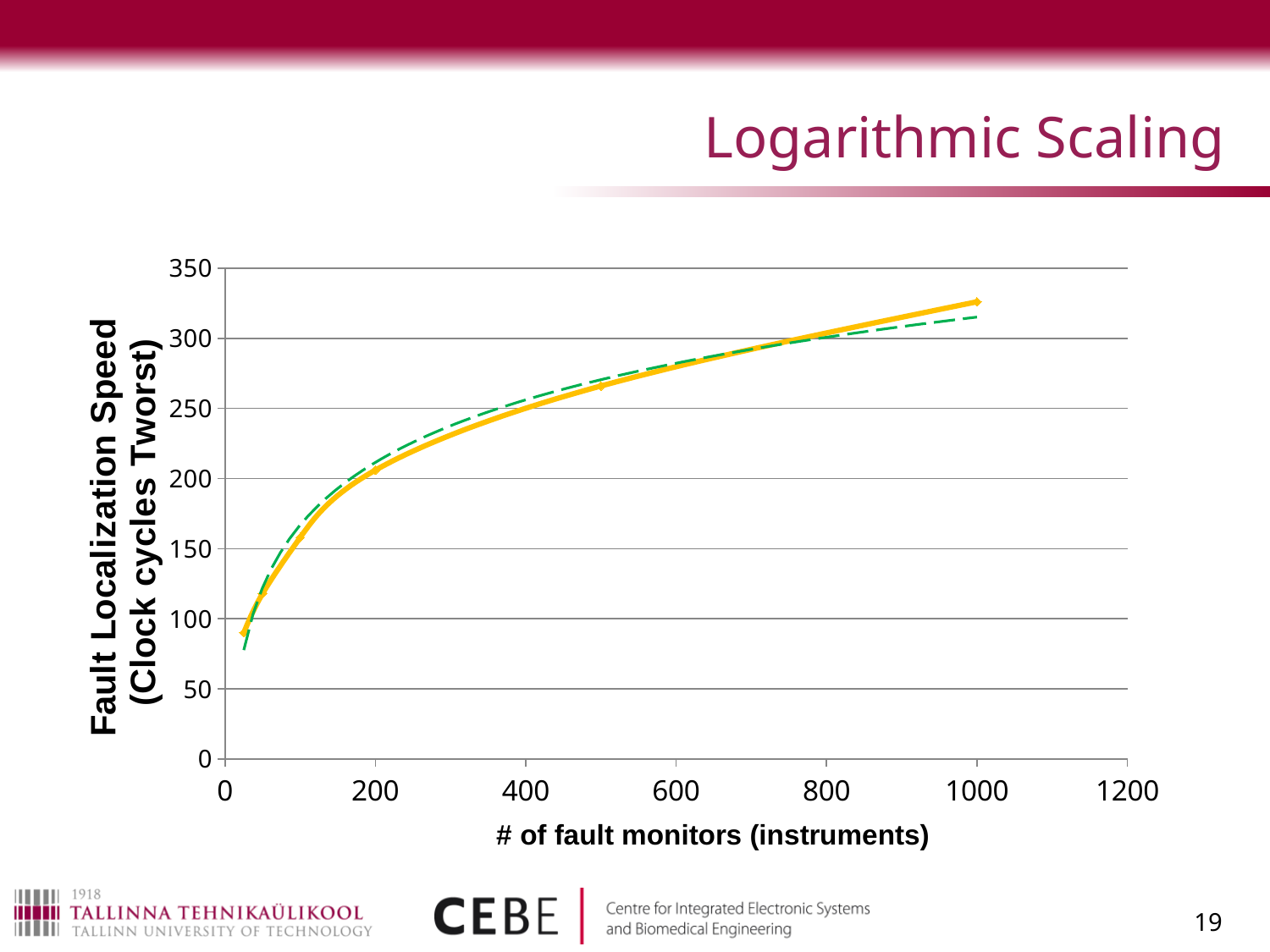
Is the value of the solid line at 200 fault monitors greater or less than 150? greater Is the value of the solid line at 1000 fault monitors greater or less than 300? greater Does the fault localization speed rise or fall as the number of fault monitors increases? rise What is the label of the x axis? # of fault monitors (instruments) Is the value of the solid line at 600 fault monitors greater or less than 300? less What kind of chart is shown on the slide? line chart What is the title of the slide containing the chart? Logarithmic Scaling